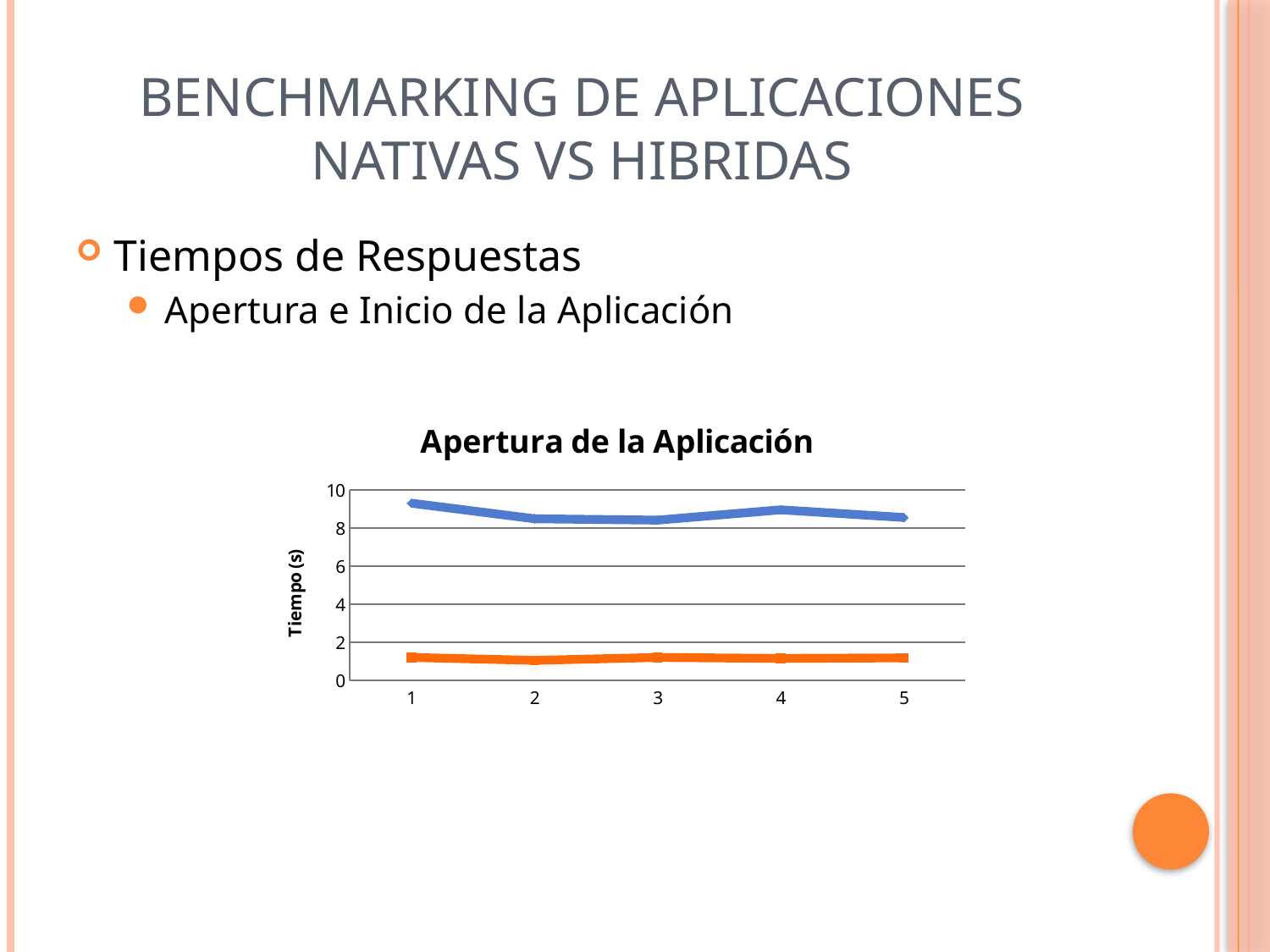
Is the value of the orange line at x = 1 greater or less than 4? less What is the label on the vertical axis of the chart? Tiempo (s) What kind of chart is shown on the slide? line chart Is the value of the blue line at x = 1 greater or less than 8? greater At x = 5, which line has the smaller value, the blue line or the orange line? the orange line Is the value of the blue line at x = 4 greater or less than 10? less How many points are plotted along the x axis of the chart? 5 At x = 2, which line has the larger value, the blue line or the orange line? the blue line How many lines are plotted in the chart? 2 What is the title of the chart? Apertura de la Aplicación